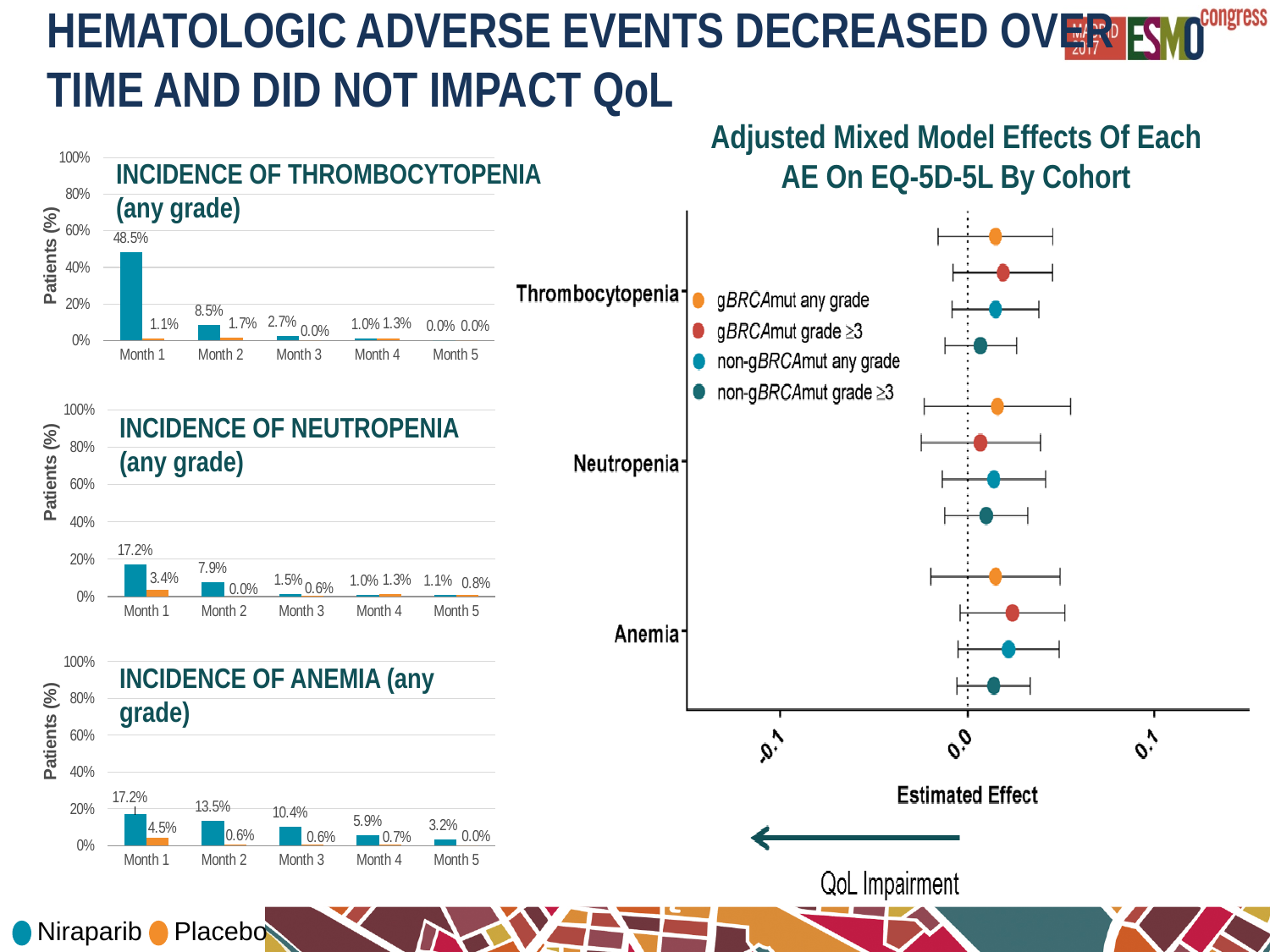
In the Incidence of Anemia chart, how many months are shown on the x axis? 5 In the Incidence of Neutropenia chart, what is the difference between the Niraparib values at Month 1 and Month 2? 9.3% In the Incidence of Thrombocytopenia chart, what is the value for Placebo at Month 2? 1.7% In the Incidence of Thrombocytopenia chart, what is the value for Niraparib at Month 1? 48.5% In the Incidence of Thrombocytopenia chart, which month has the highest Niraparib value? Month 1 What kind of chart is the Incidence of Anemia chart? bar chart In the Incidence of Thrombocytopenia chart, what is the difference between the Niraparib and Placebo values at Month 1? 47.4% In the Incidence of Neutropenia chart, which is larger at Month 4, Niraparib or Placebo? Placebo In the Incidence of Anemia chart, do the Niraparib values rise or fall from Month 1 to Month 5? fall In the Adjusted Mixed Model Effects chart, how many series does the legend list? 4 In the Incidence of Neutropenia chart, what is the value for Placebo at Month 1? 3.4% In the Incidence of Anemia chart, what is the value for Niraparib at Month 3? 10.4%